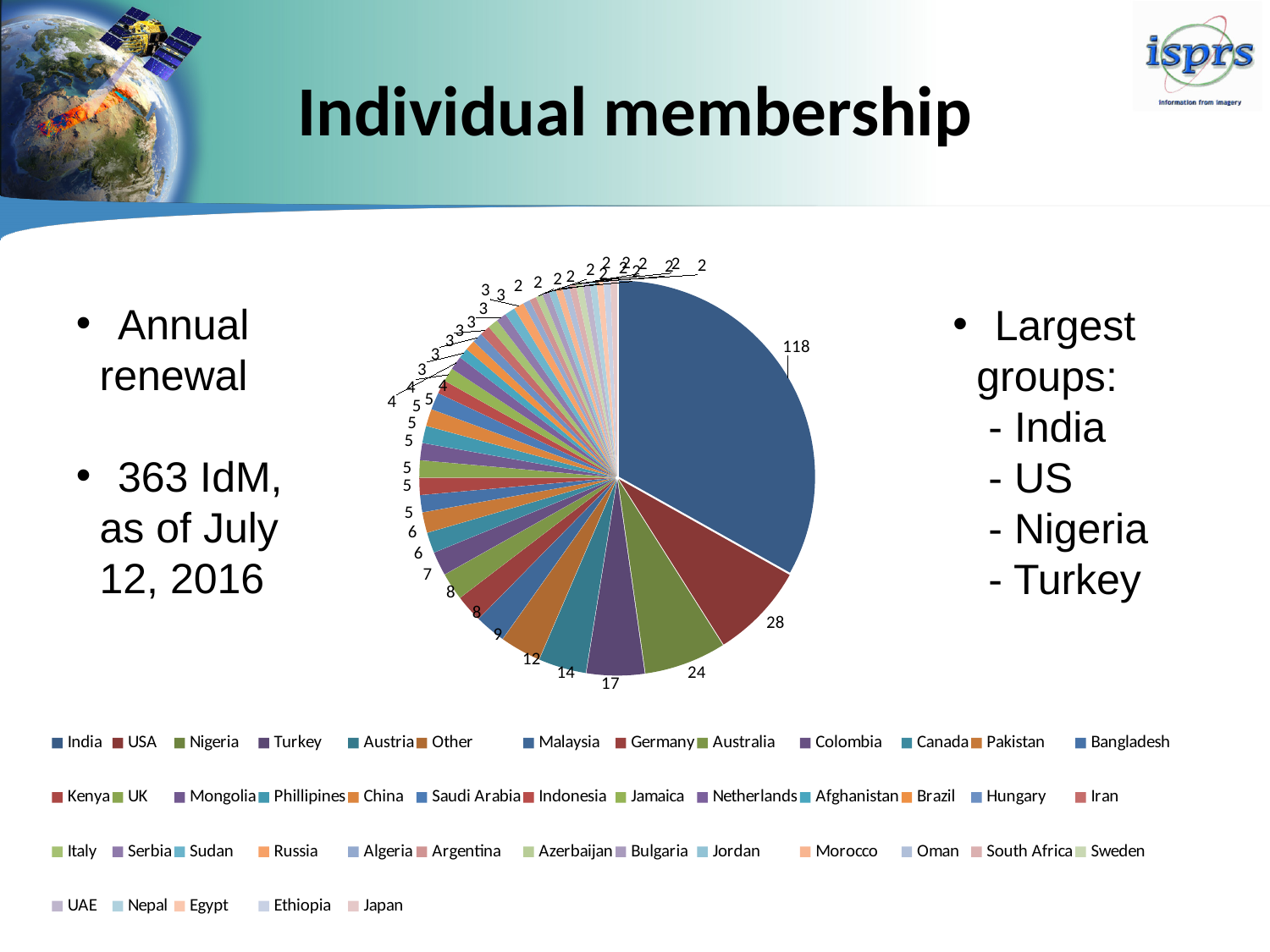
What is the difference between the values for India and USA? 90 What is the value for Austria in the pie chart? 14 Which country has the largest slice in the pie chart? India What is the value for India in the pie chart? 118 What is the difference between the values for USA and Nigeria? 4 What is the value for Turkey in the pie chart? 17 What is the value for Nigeria in the pie chart? 24 What is the title of the slide containing the pie chart? Individual membership What is the value for Malaysia in the pie chart? 9 What type of chart is shown on the slide? pie chart What is the value for USA in the pie chart? 28 Which is larger, the value for Nigeria or the value for Turkey? Nigeria